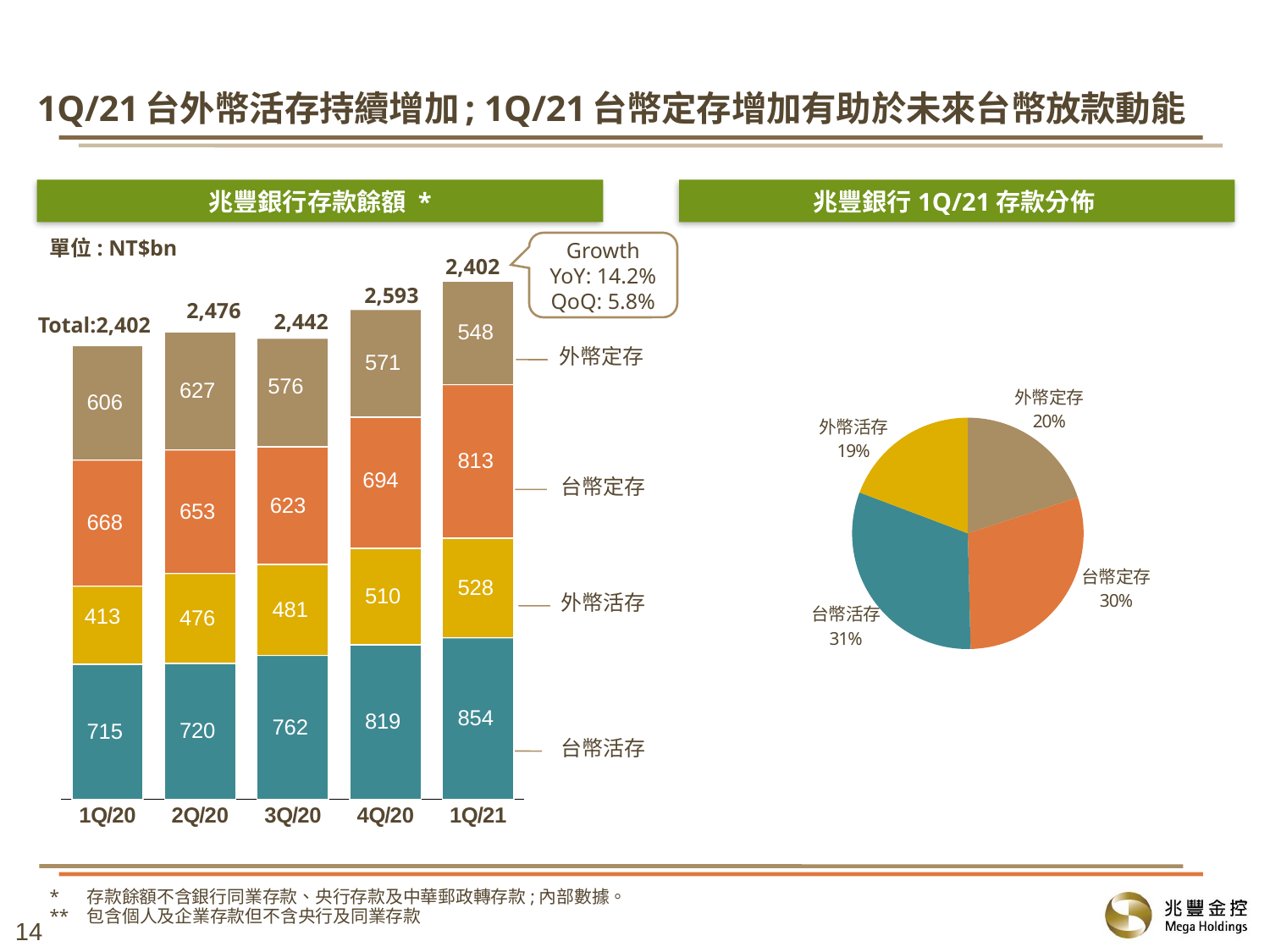
In the 兆豐銀行存款餘額 bar chart, does 台幣活存 rise or fall from 1Q/20 to 1Q/21? rises In the 兆豐銀行存款餘額 bar chart, what is the value of 外幣定存 for 2Q/20? 627 In the 兆豐銀行存款餘額 bar chart, by how much did 台幣活存 increase from 1Q/20 to 1Q/21? 139 How many quarters are shown on the x axis of the 兆豐銀行存款餘額 bar chart? 5 In the 兆豐銀行存款餘額 bar chart, is 台幣定存 larger in 4Q/20 or 1Q/21? 1Q/21 In the 兆豐銀行 1Q/21 存款分佈 pie chart, which category has the smallest share? 外幣活存 In the 兆豐銀行存款餘額 bar chart, what is the total deposit balance shown for 4Q/20? 2,593 In the 兆豐銀行 1Q/21 存款分佈 pie chart, what share does 台幣活存 have? 31% In the 兆豐銀行存款餘額 bar chart, which quarter has the lowest 外幣活存 value? 1Q/20 In the 兆豐銀行存款餘額 bar chart, which quarter has the highest 台幣活存 value? 1Q/21 How many deposit categories are stacked in each bar of the 兆豐銀行存款餘額 chart? 4 In the 兆豐銀行存款餘額 bar chart, what is the value of 台幣活存 for 1Q/21? 854